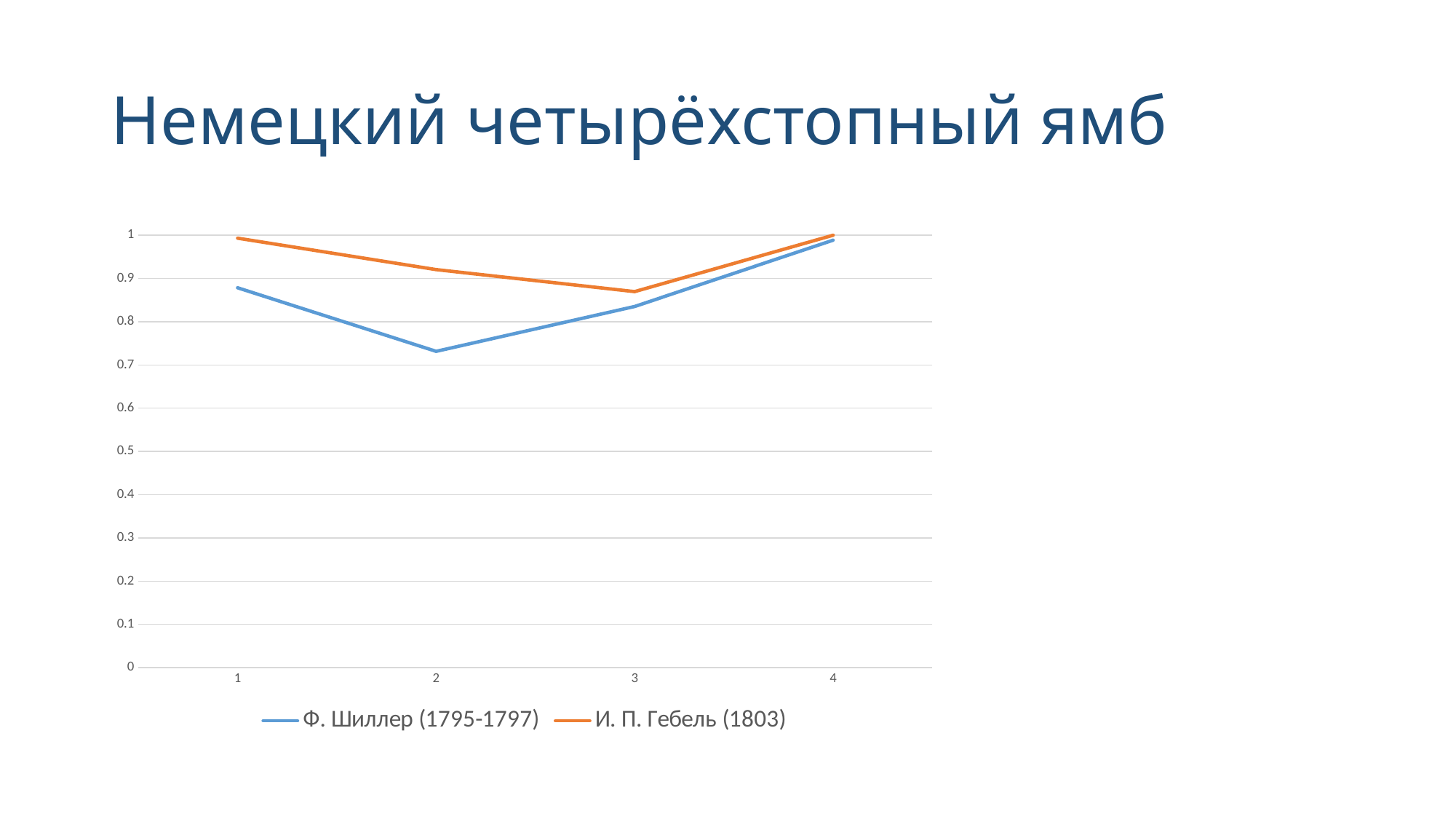
At position 1, which series has the larger value, Ф. Шиллер (1795-1797) or И. П. Гебель (1803)? И. П. Гебель (1803) Is the value for И. П. Гебель (1803) at position 2 greater or less than 0.9? greater What is the title of the slide? Немецкий четырёхстопный ямб At which x-axis position is the value for Ф. Шиллер (1795-1797) lowest? 2 What kind of chart is shown on the slide? line chart How many points are plotted along the x axis for each series? 4 Do the values for Ф. Шиллер (1795-1797) rise or fall from position 2 to position 4? rise Which series is shown in orange? И. П. Гебель (1803) How many series does the legend list? 2 Is the value for Ф. Шиллер (1795-1797) at position 2 greater or less than 0.8? less At which x-axis position is the value for И. П. Гебель (1803) lowest? 3 At which x-axis position is the value for Ф. Шиллер (1795-1797) highest? 4